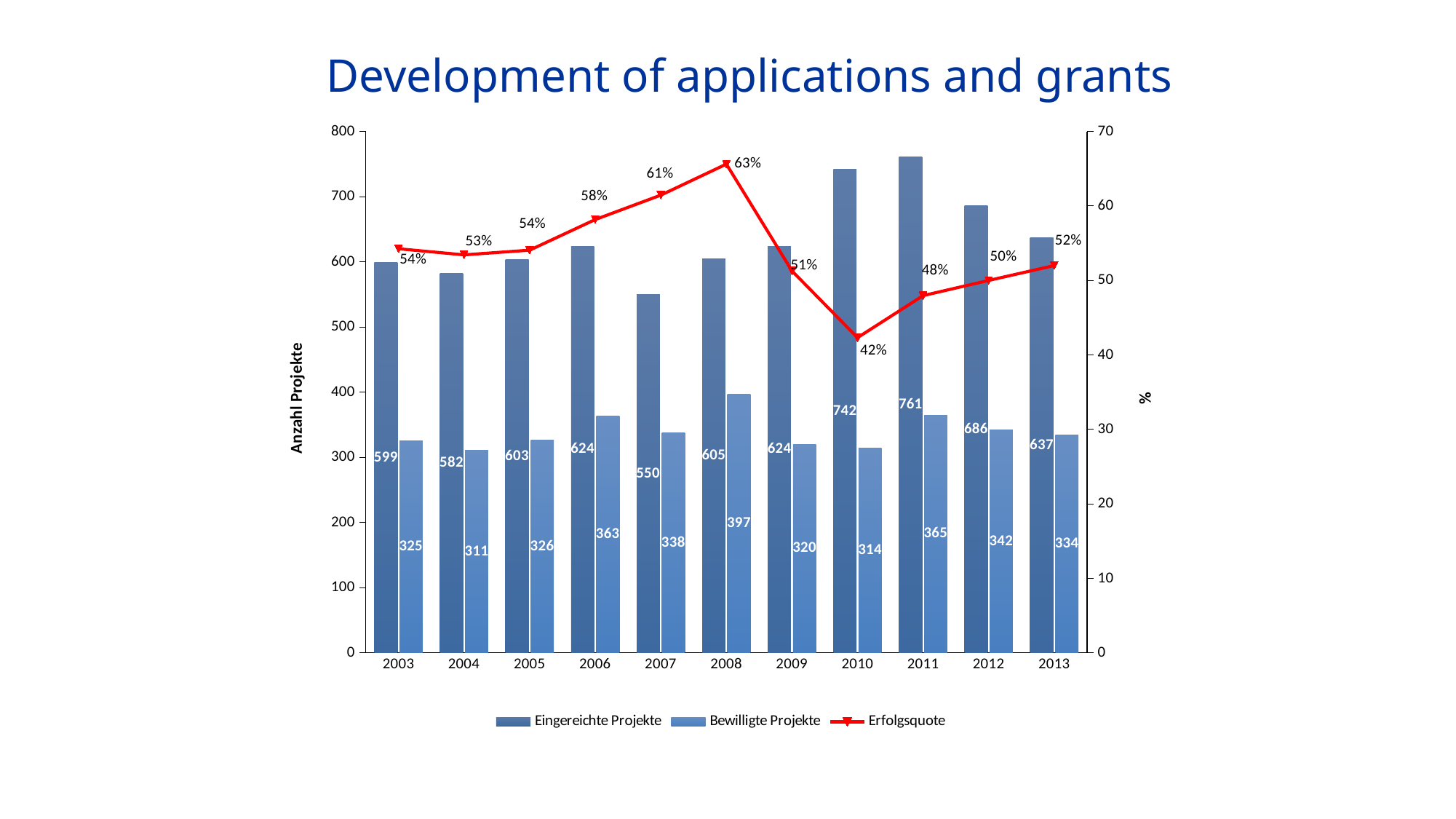
What kind of chart is this? Combined bar and line chart How many series does the legend list? 3 What is the Erfolgsquote for 2006? 58% What is the difference between Eingereichte Projekte and Bewilligte Projekte in 2013? 303 Which year has the lowest Erfolgsquote? 2010 How many years are shown on the x axis? 11 Which year has the lowest value for Bewilligte Projekte? 2004 Which is larger: Eingereichte Projekte in 2007 or in 2009? 2009 Which year has the highest value for Eingereichte Projekte? 2011 What is the value of Bewilligte Projekte for 2008? 397 What is the value of Eingereichte Projekte for 2010? 742 What is the title of the slide? Development of applications and grants